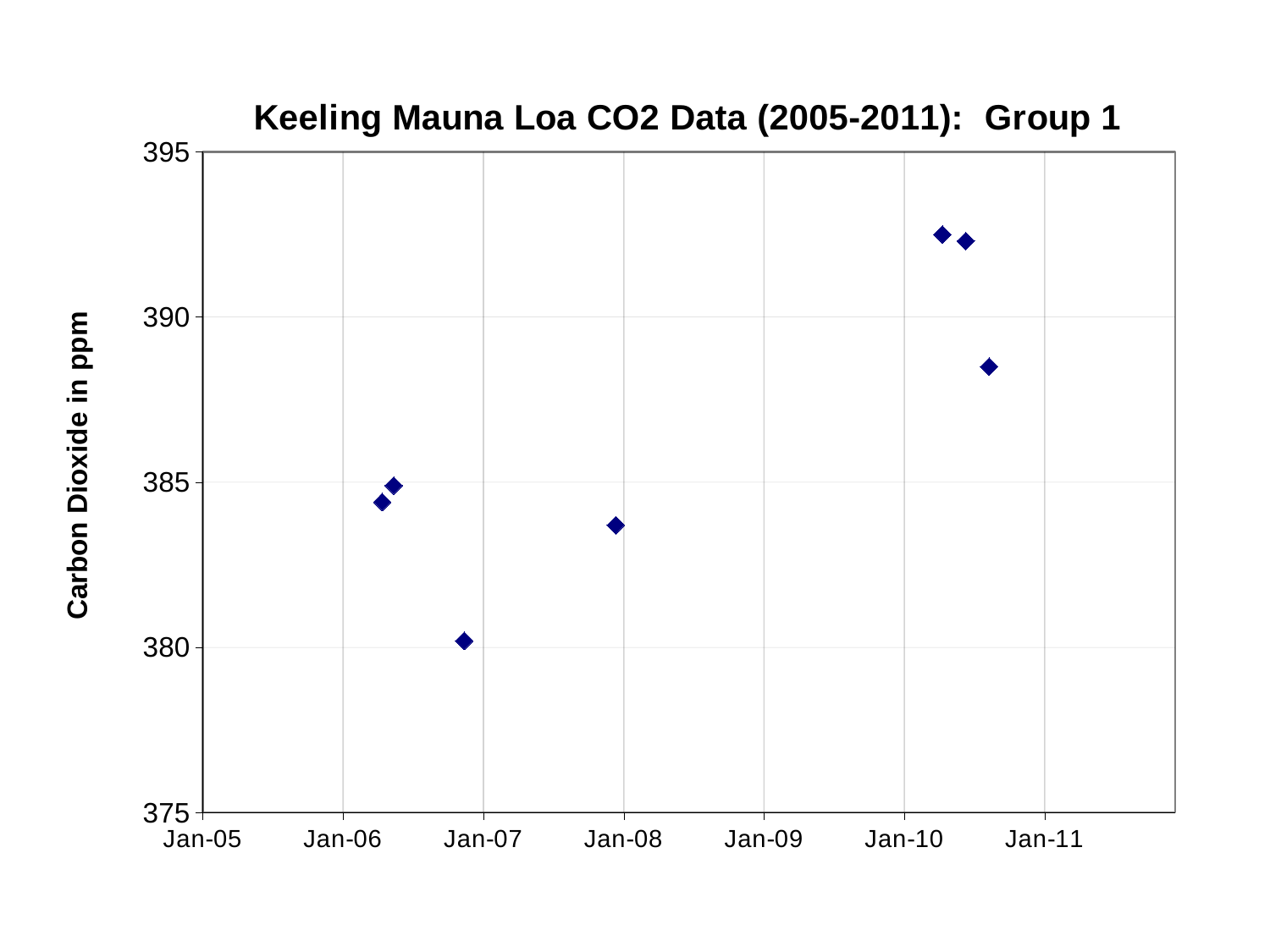
How many points are plotted between Jan-10 and Jan-11? 3 Is the value of the point plotted just before Jan-07 greater or less than 385? less What kind of chart is shown on the slide? scatter chart Is the value of the point plotted between Jan-10 and Jan-11 that lies below the other two greater or less than 390? less Overall, do the CO2 values rise or fall from 2006 to 2010 along the x axis? rise Which is larger: the value of the point near Jan-08 or the value of the point just before Jan-07? the point near Jan-08 How many data points are plotted on the chart? 7 What is the label of the vertical axis? Carbon Dioxide in ppm What is the title of the chart? Keeling Mauna Loa CO2 Data (2005-2011): Group 1 Are the values of the two points plotted shortly after Jan-10 greater or less than 390? greater